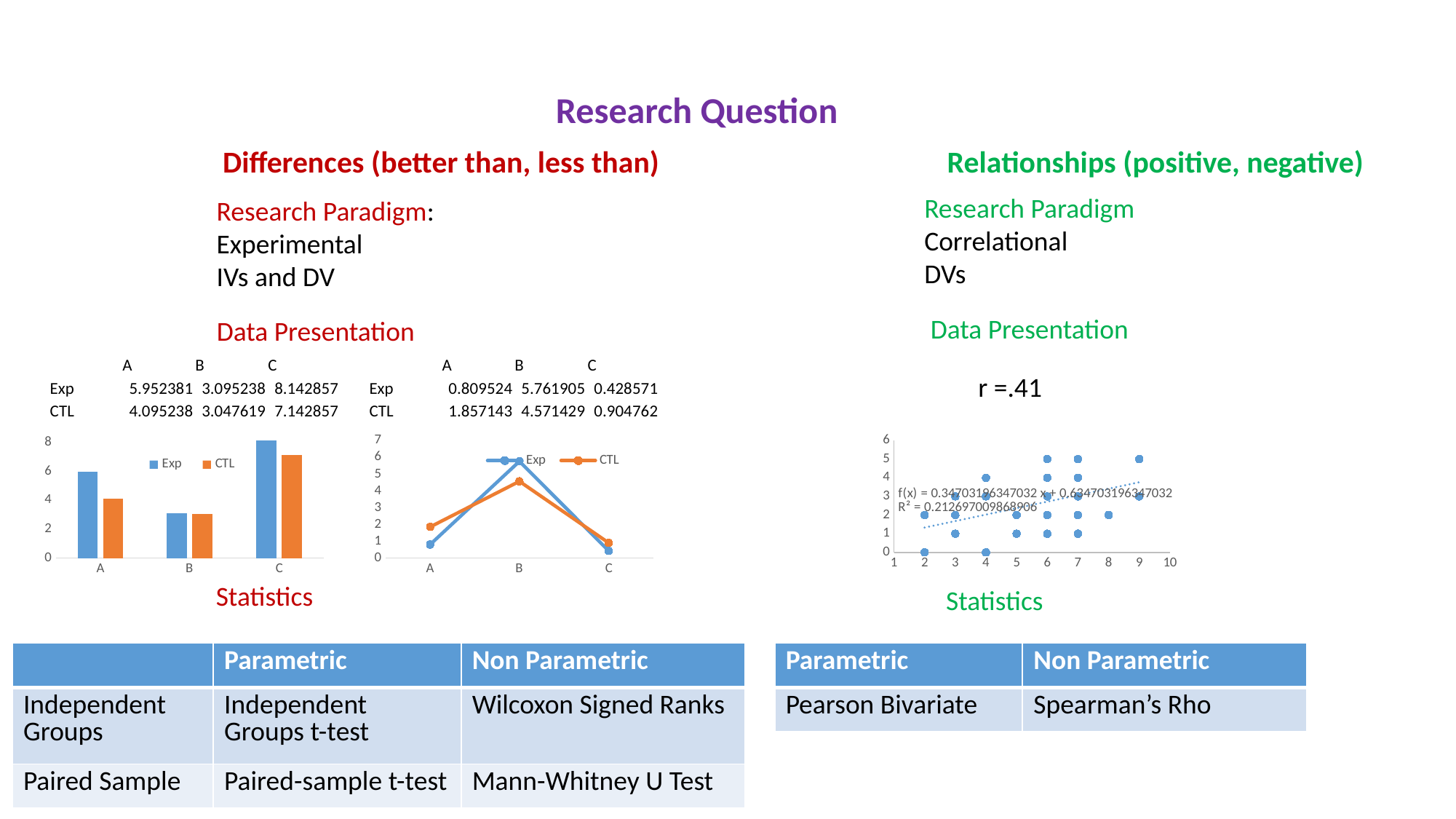
In the bar chart on the left, which category has the highest Exp value? C In the bar chart on the left, what is the Exp value for category C? 8.142857 In the bar chart on the left, which category has the lowest CTL value? B In the line chart in the middle, which is larger at category A, Exp or CTL? CTL In the bar chart on the left, what is the CTL value for category A? 4.095238 In the line chart in the middle, what is the Exp value for category B? 5.761905 What correlation coefficient r is shown above the scatter plot on the right? r =.41 What kind of chart is shown on the right side of the slide under Data Presentation? scatter plot How many series does the legend of the bar chart on the left list? 2 In the line chart in the middle, which category has the highest CTL value? B In the bar chart on the left, is the Exp value for category A greater or less than 4? greater In the line chart in the middle, what is the CTL value for category C? 0.904762